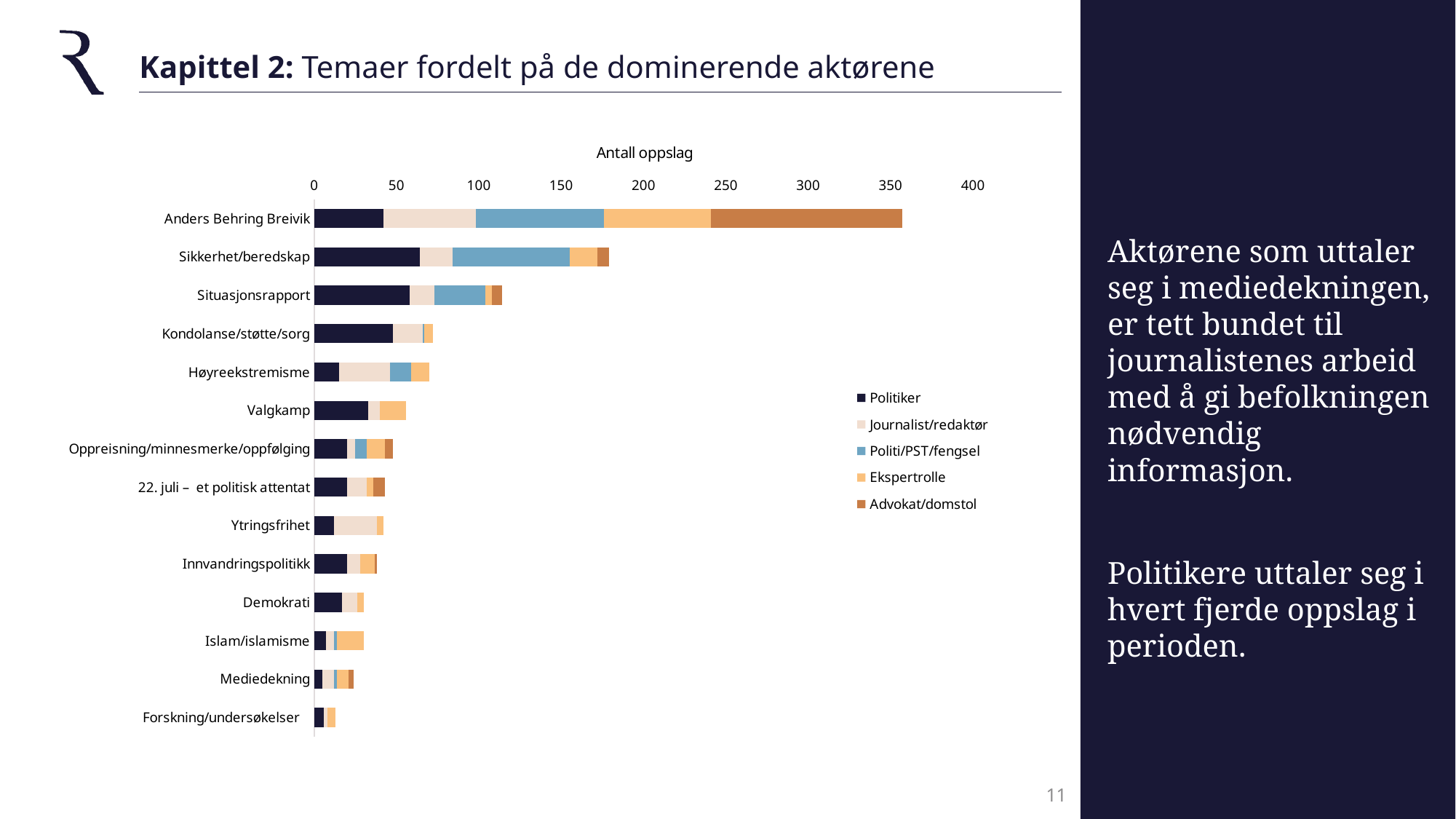
How many series does the legend list? 5 Which has a larger total, Sikkerhet/beredskap or Situasjonsrapport? Sikkerhet/beredskap What is the title of the horizontal axis? Antall oppslag Is the total value for Situasjonsrapport greater or less than 100? greater Is the total value for Sikkerhet/beredskap greater or less than 150? greater Which topic has the lowest total number of oppslag? Forskning/undersøkelser What kind of chart is shown on the slide? Stacked bar chart Is the total value for Ytringsfrihet greater or less than 50? less Which topic has the highest total number of oppslag? Anders Behring Breivik Which series is shown in the darkest (navy) colour in the legend? Politiker How many topic categories are plotted on the chart? 14